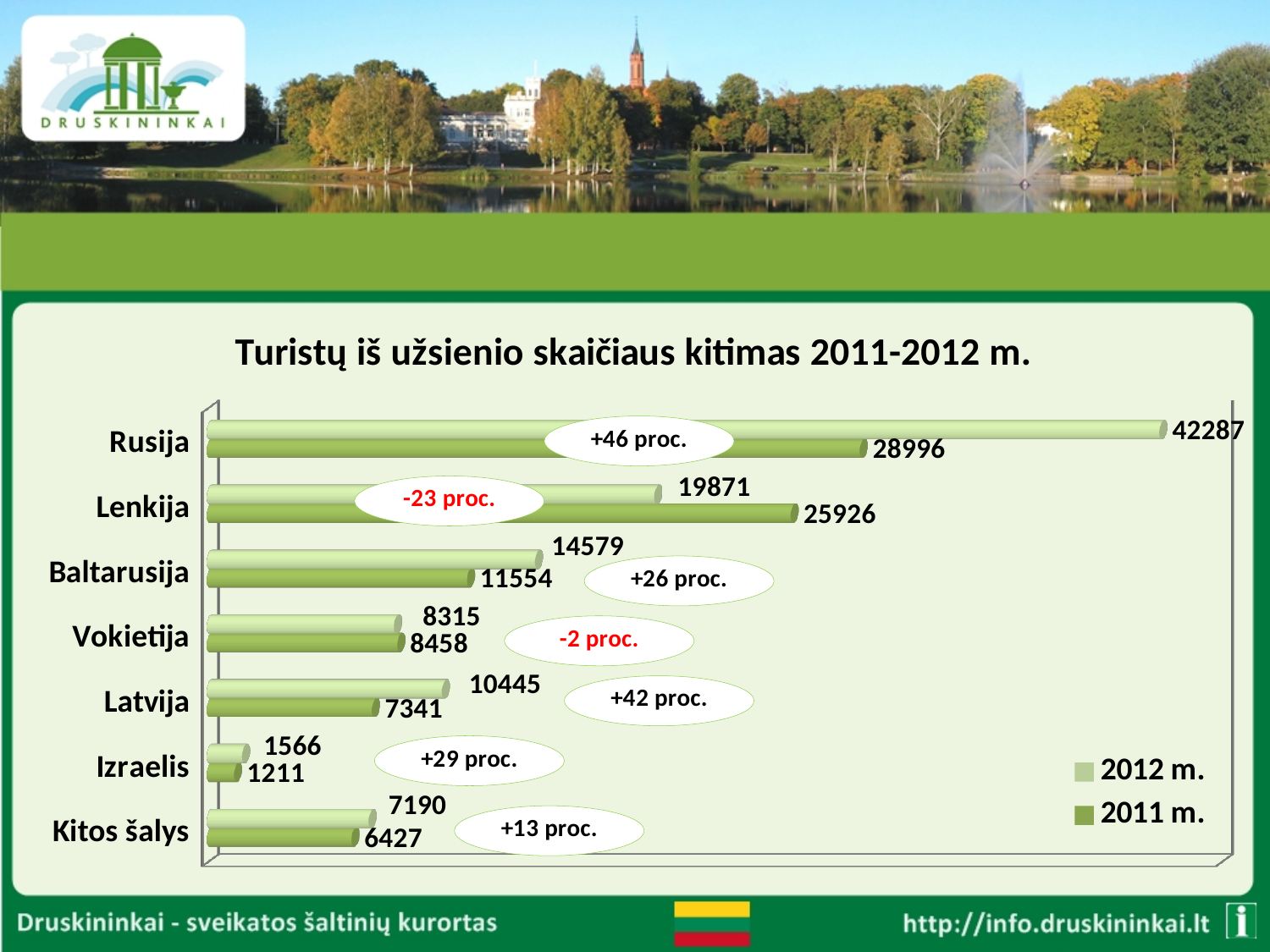
Which category has the highest value in the 2012 m. series? Rusija What is the difference between the 2012 m. and 2011 m. values for Rusija? 13291 What type of chart is shown on the slide? bar chart How many categories are shown on the chart? 7 What percentage change is shown in the label for Baltarusija? +26 proc. Which category has the lowest value in the 2011 m. series? Izraelis What is the value for Latvija in the 2012 m. series? 10445 How many series does the legend list? 2 What is the value for Lenkija in the 2011 m. series? 25926 Which is larger for Lenkija: the 2012 m. value or the 2011 m. value? 2011 m. What is the value for Izraelis in the 2011 m. series? 1211 What is the value for Rusija in the 2012 m. series? 42287